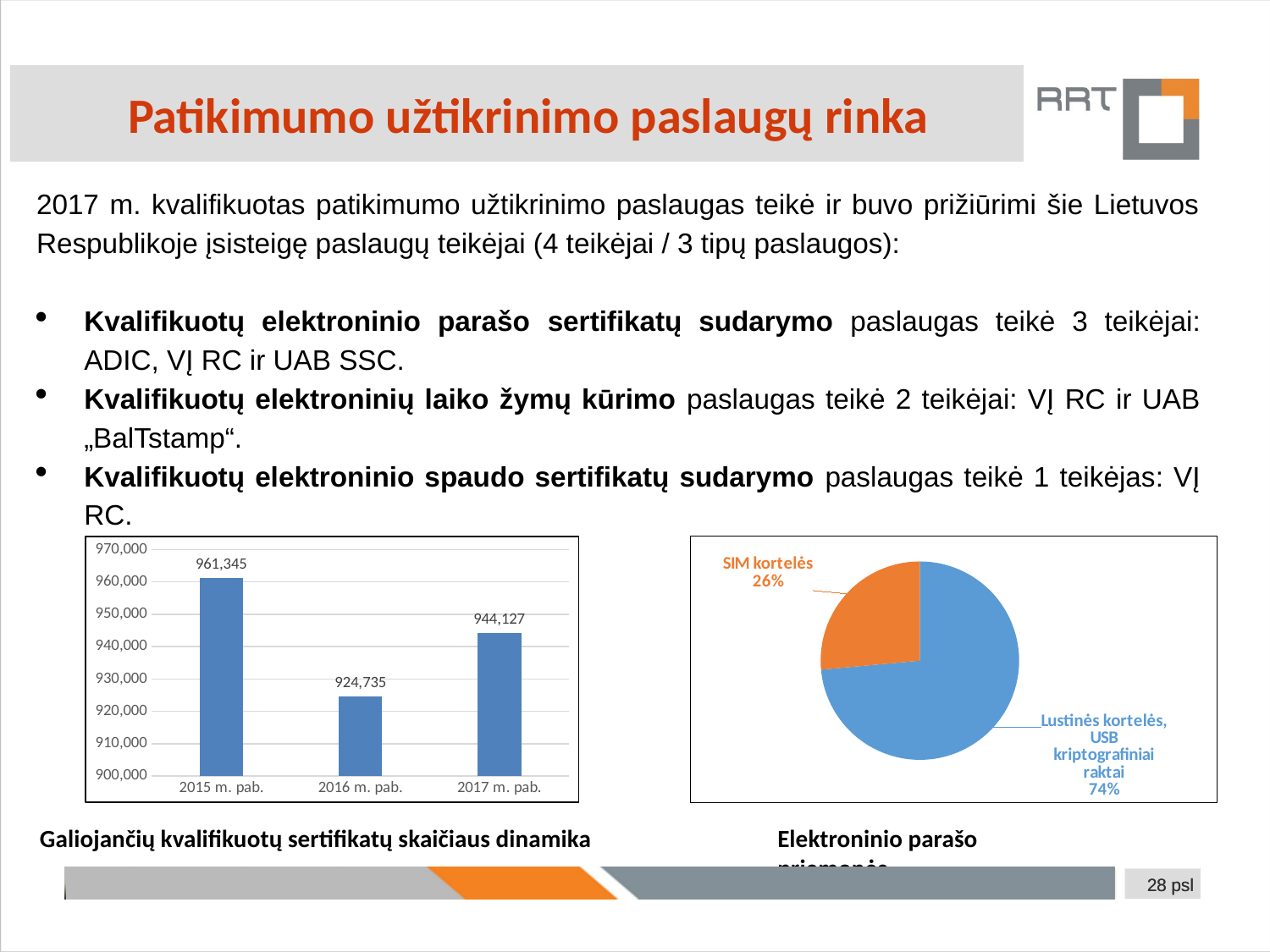
In the pie chart on the right, what share is labelled for SIM kortelės? 26% In the pie chart on the right, what share is labelled for Lustinės kortelės, USB kriptografiniai raktai? 74% In the bar chart on the left, is the value for 2017 m. pab. larger than the value for 2016 m. pab.? Yes In the bar chart on the left, how many bars are plotted? 3 In the bar chart on the left, which year has the highest value? 2015 m. pab. In the bar chart on the left, what is the difference between the values for 2015 m. pab. and 2016 m. pab.? 36,610 In the bar chart on the left, what is the value for 2015 m. pab.? 961,345 What kind of chart is the chart on the right of the slide? Pie chart In the bar chart on the left, which year has the lowest value? 2016 m. pab. In the bar chart on the left, what is the value for 2016 m. pab.? 924,735 In the bar chart on the left, what is the value for 2017 m. pab.? 944,127 What kind of chart is the chart on the left of the slide? Bar chart